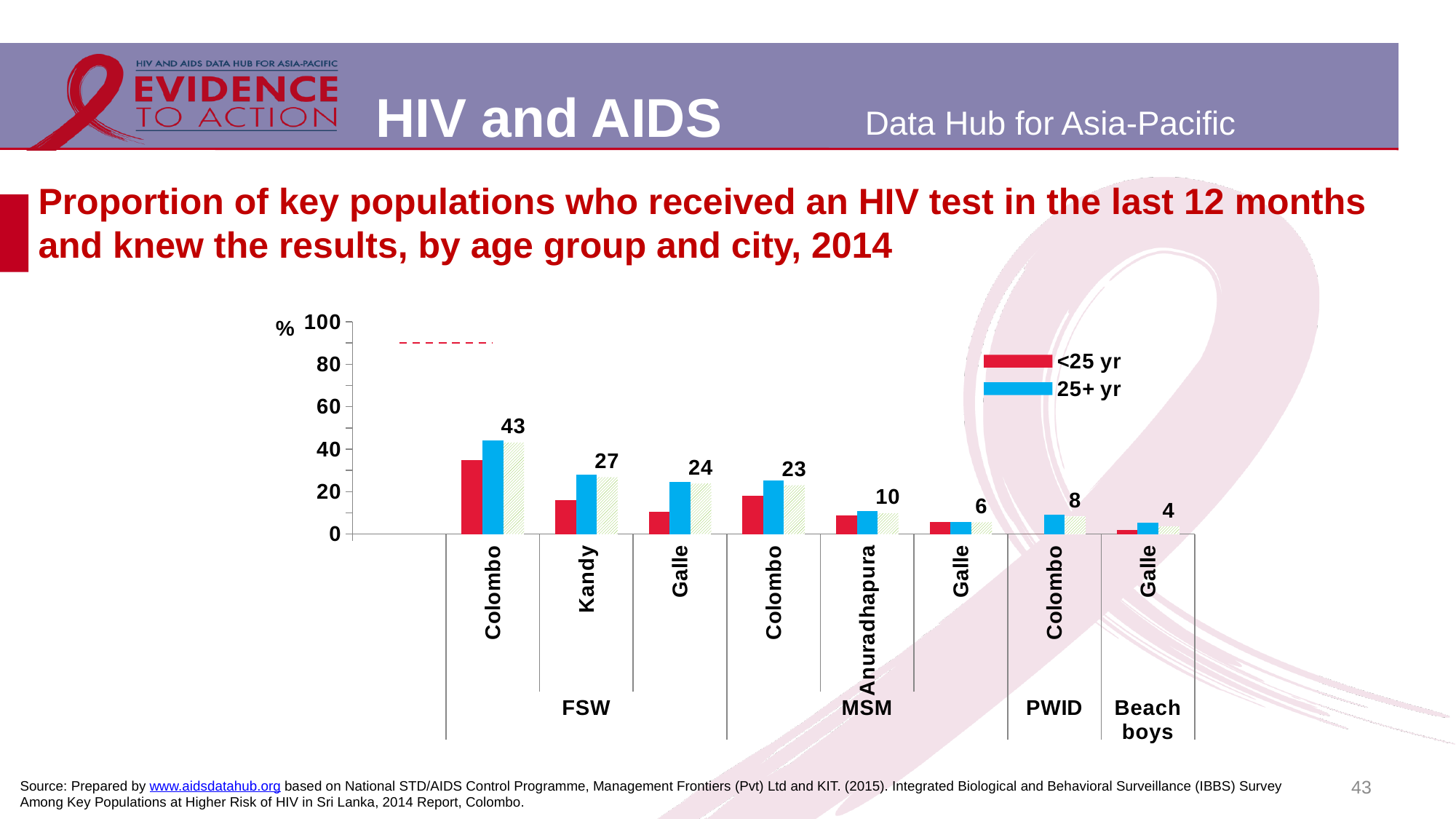
What is the data label printed above the bars for Galle in the Beach boys group? 4 How many city categories are shown along the x axis? 8 What is the data label printed above the bars for Anuradhapura in the MSM group? 10 How many series does the legend list? 2 What is the data label printed above the bars for Colombo in the FSW group? 43 Which city group has the lowest printed data label? Galle (Beach boys) What is the difference between the printed data labels for Colombo (FSW) and Kandy (FSW)? 16 Is the value of the <25 yr bar for Kandy in the FSW group greater or less than 20? less Which city group has the highest printed data label? Colombo (FSW) What kind of chart is shown on the slide? bar chart What are the two series named in the legend? <25 yr and 25+ yr What colour represents the <25 yr series? red